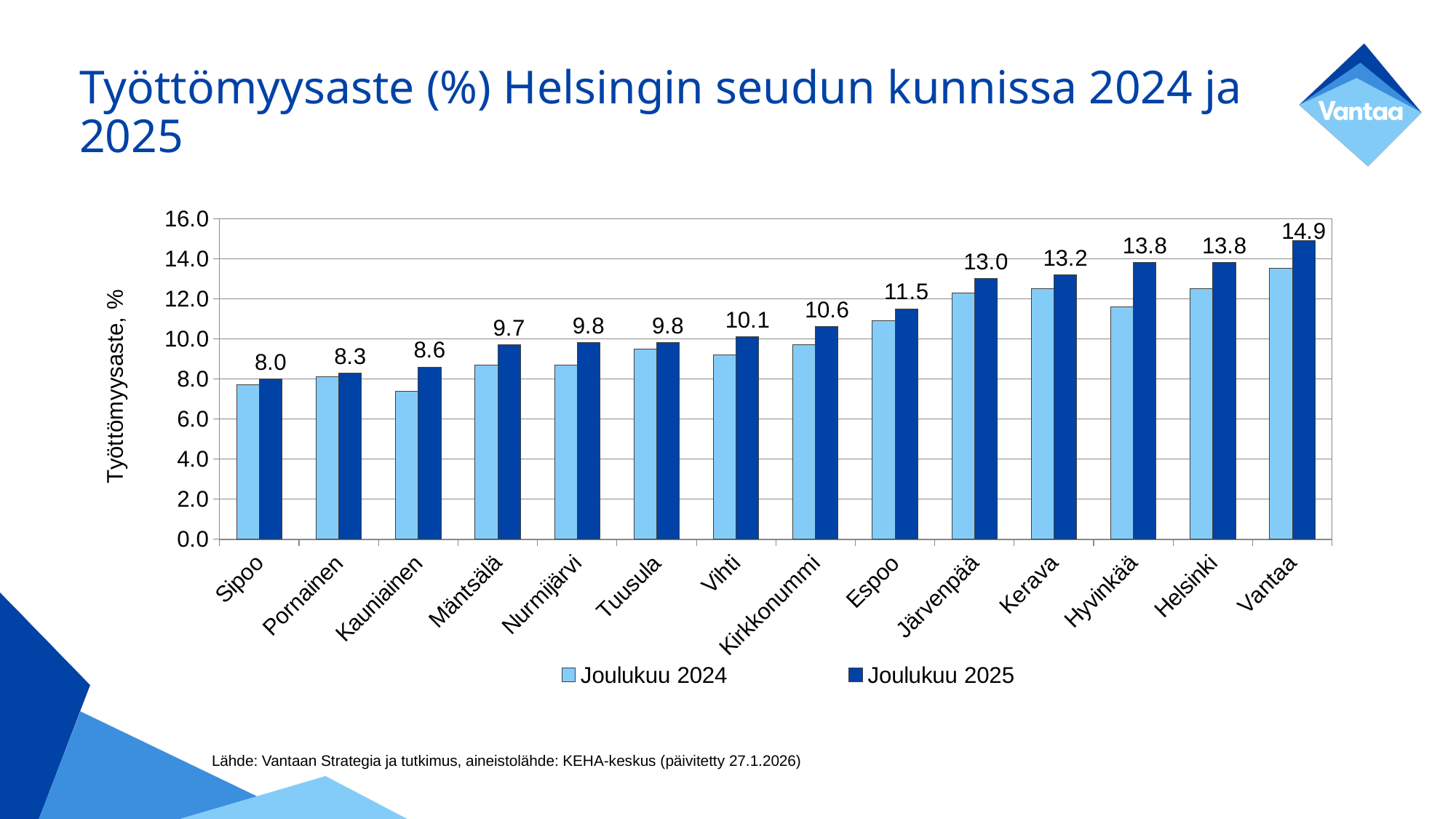
Which municipality has the lowest unemployment rate in Joulukuu 2025? Sipoo What is the unemployment rate for Vantaa in Joulukuu 2025? 14.9 How many municipalities are shown on the x axis of the chart? 14 What is the unemployment rate for Sipoo in Joulukuu 2025? 8.0 How many series does the legend list? 2 What is the difference between the Joulukuu 2025 unemployment rates of Helsinki and Espoo? 2.3 What is the difference between the Joulukuu 2025 unemployment rates of Vantaa and Sipoo? 6.9 Is the Joulukuu 2024 value for Vantaa greater or less than 12.0? greater Is the Joulukuu 2024 value for Kauniainen greater or less than 8.0? less Which has the higher Joulukuu 2025 unemployment rate, Kerava or Järvenpää? Kerava Which municipality has the highest unemployment rate in Joulukuu 2025? Vantaa What is the unemployment rate for Espoo in Joulukuu 2025? 11.5